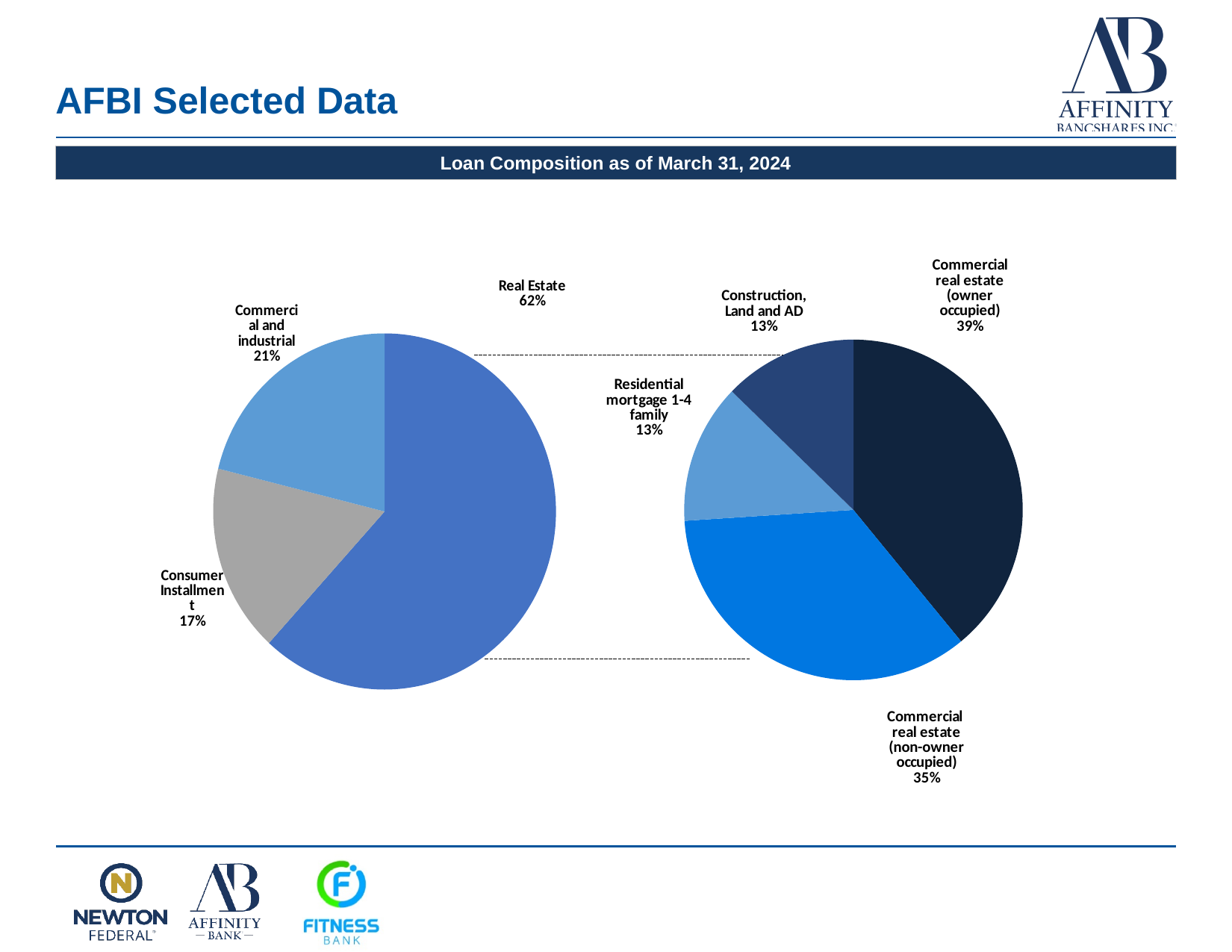
In the left pie chart, which category has the largest share? Real Estate In the right pie chart, what share is Commercial real estate (non-owner occupied)? 35% In the left pie chart, which category has the smallest share? Consumer Installment In the right pie chart, what share is Commercial real estate (owner occupied)? 39% How many slices does the left pie chart have? 3 In the left pie chart, what share of loans is Real Estate? 62% In the left pie chart, what share is Commercial and industrial? 21% What kind of chart is used on the left side of the slide? pie chart In the left pie chart, what share is Consumer Installment? 17% How many slices does the right pie chart have? 4 In the left pie chart, how many percentage points larger is Commercial and industrial than Consumer Installment? 4 In the right pie chart, which is larger: Commercial real estate (owner occupied) or Residential mortgage 1-4 family? Commercial real estate (owner occupied)